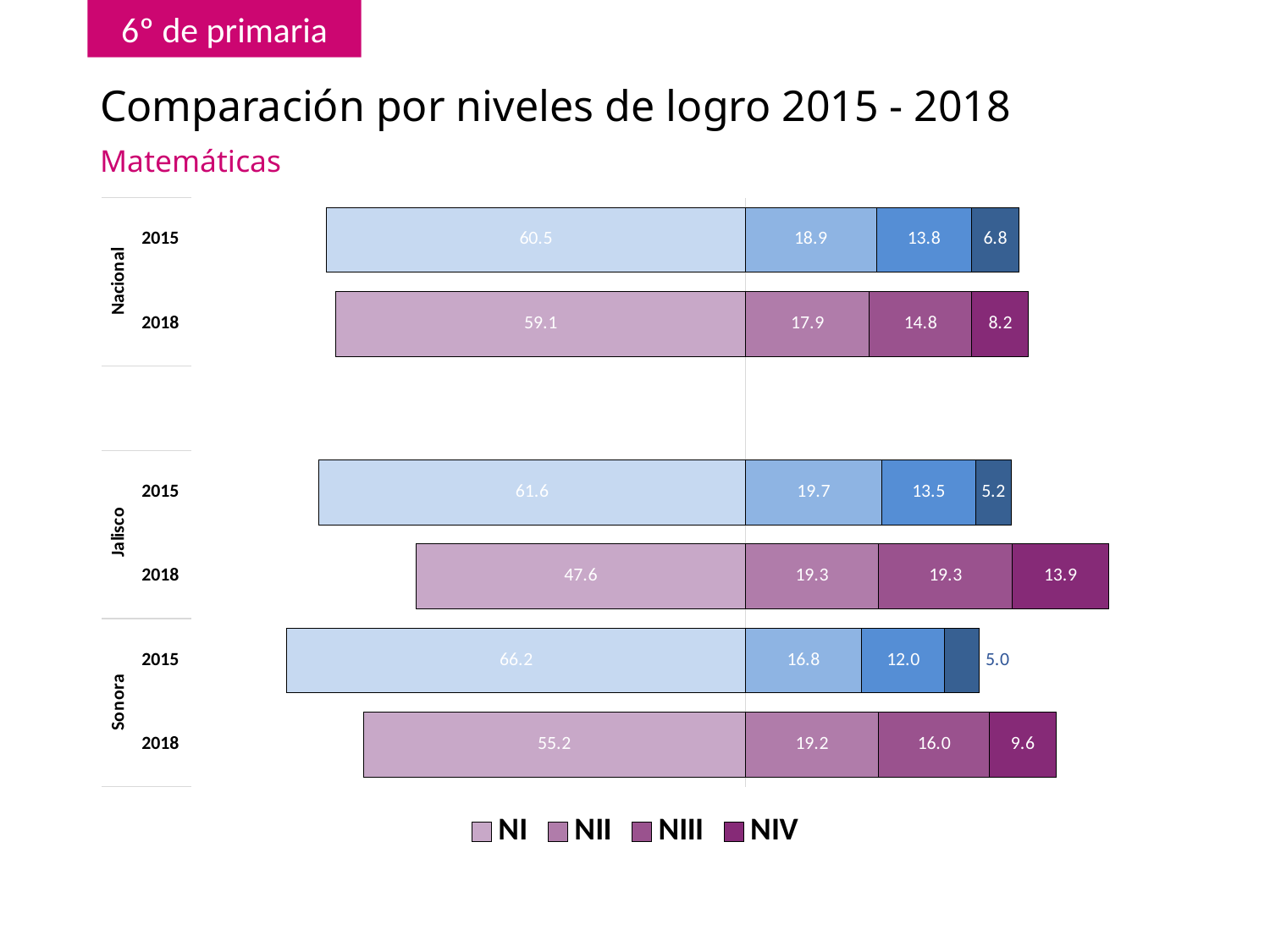
What is the difference between the NIV values for Nacional in 2018 and 2015? 1.4 What is the NII value for Sonora in 2015? 16.8 Which is larger, the NII value for Sonora 2018 or for Nacional 2018? Sonora 2018 By how much did the NI value for Jalisco fall from 2015 to 2018? 14.0 Which bar has the highest NI value? Sonora 2015 What kind of chart is shown on the slide? Stacked bar chart What is the NI value for Nacional in 2018? 59.1 How many series does the legend list? 4 What is the NIV value for Jalisco in 2018? 13.9 What are the legend entries of the chart? NI, NII, NIII, NIV How many bars are plotted in the chart? 6 Which bar has the lowest NIV value? Sonora 2015